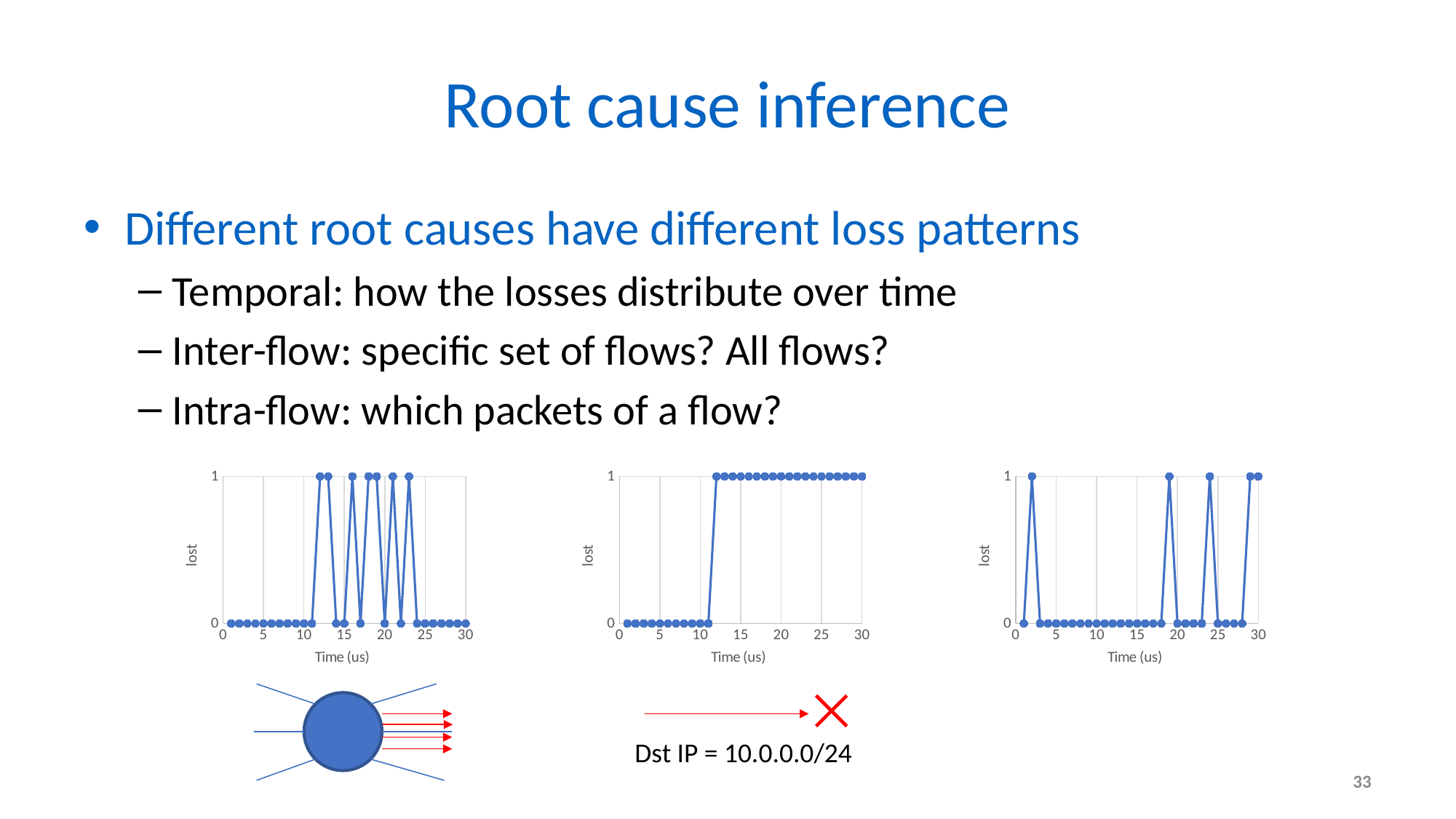
What is the y-axis label of the right chart? lost In the middle chart, what is the value of lost at time 20? 1 How many line charts are shown on the slide? 3 In the right chart, what is the value of lost at time 30? 1 In the right chart, what is the value of lost at time 10? 0 What kind of chart is the left chart on the slide? line chart What is the x-axis label of the middle chart? Time (us) In the left chart, what is the value of lost at time 5? 0 In the left chart, what is the value of lost at time 28? 0 In the middle chart, does the value of lost rise or fall as time goes from 10 to 15? rise In the middle chart, what is the value of lost at time 5? 0 In the middle chart, what is the value of lost at time 30? 1